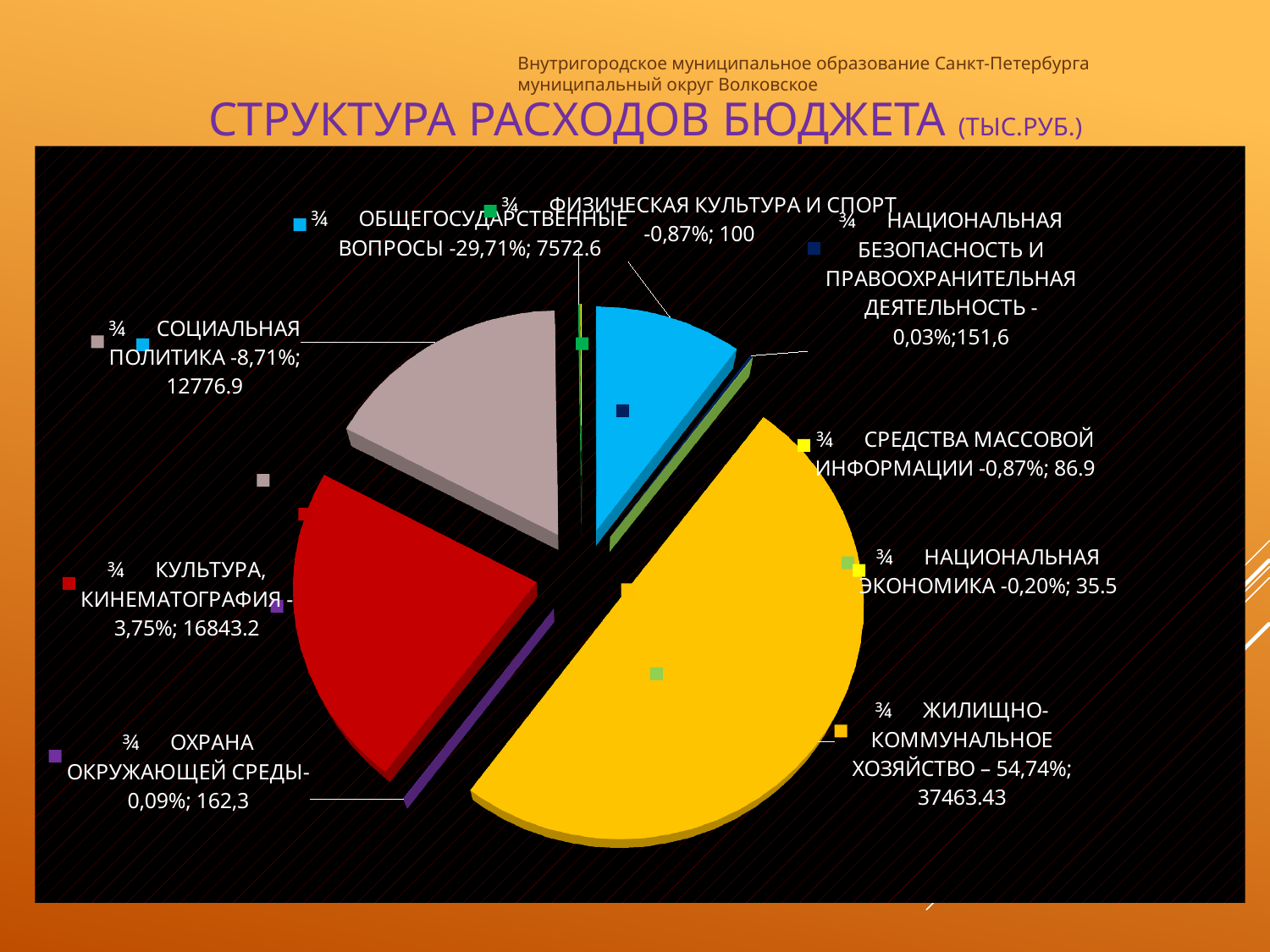
What share of the pie does НАЦИОНАЛЬНАЯ ЭКОНОМИКА have? 0,20% What value is printed for ОБЩЕГОСУДАРСТВЕННЫЕ ВОПРОСЫ? 7572.6 What share of the pie does КУЛЬТУРА, КИНЕМАТОГРАФИЯ have? 3,75% How many categories (slices) are labelled in the pie chart? 9 What kind of chart is shown on the slide? Pie chart Which category has the smallest printed share of the pie? НАЦИОНАЛЬНАЯ БЕЗОПАСНОСТЬ И ПРАВООХРАНИТЕЛЬНАЯ ДЕЯТЕЛЬНОСТЬ What share of the pie does ЖИЛИЩНО-КОММУНАЛЬНОЕ ХОЗЯЙСТВО have? 54,74% What value is printed for ОХРАНА ОКРУЖАЮЩЕЙ СРЕДЫ? 162,3 What is the title of the chart on the slide? СТРУКТУРА РАСХОДОВ БЮДЖЕТА (ТЫС.РУБ.) Which slice is larger: ЖИЛИЩНО-КОММУНАЛЬНОЕ ХОЗЯЙСТВО or ОБЩЕГОСУДАРСТВЕННЫЕ ВОПРОСЫ? ЖИЛИЩНО-КОММУНАЛЬНОЕ ХОЗЯЙСТВО Which category has the largest slice of the pie? ЖИЛИЩНО-КОММУНАЛЬНОЕ ХОЗЯЙСТВО What value is printed for СОЦИАЛЬНАЯ ПОЛИТИКА? 12776.9